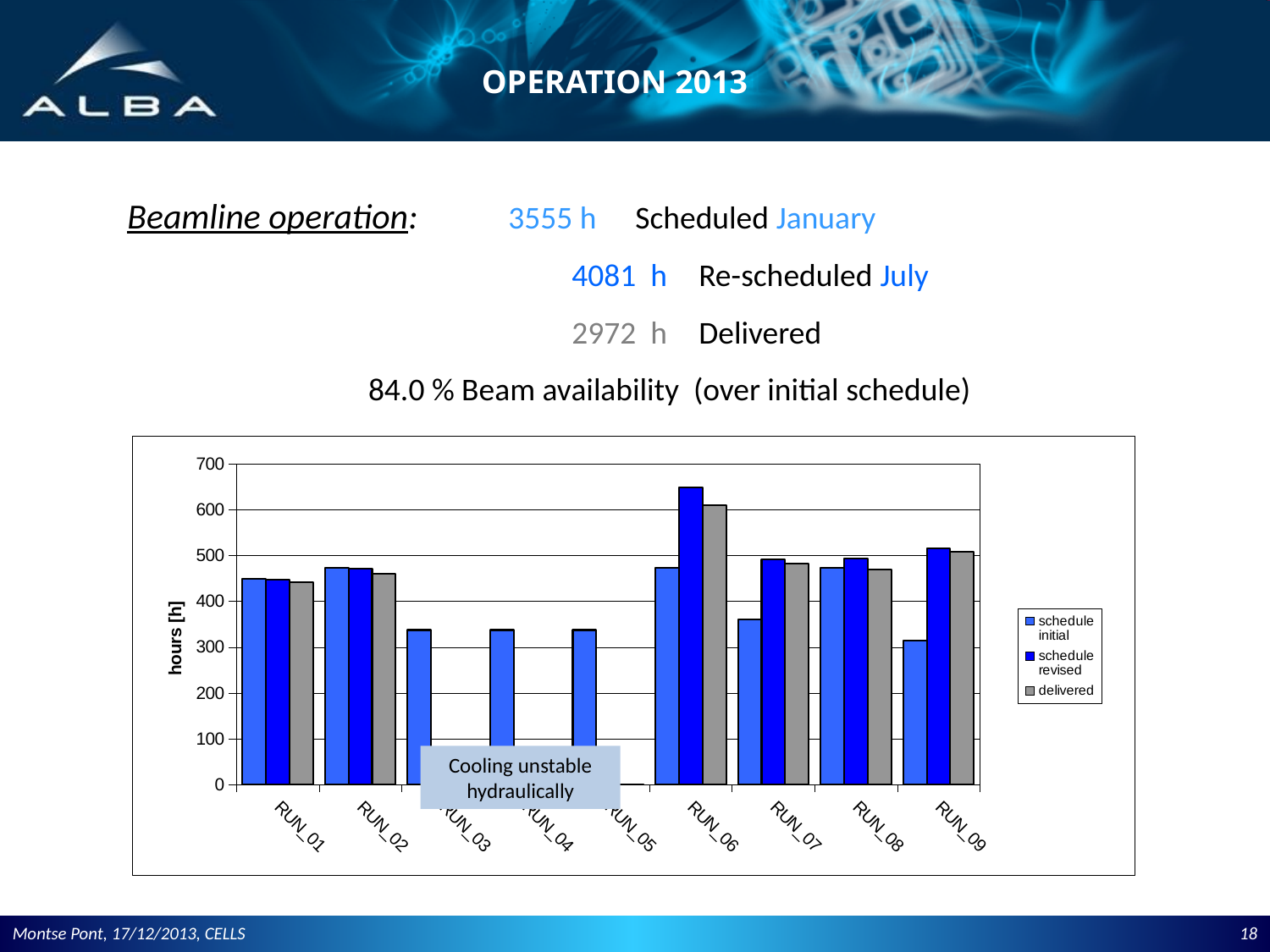
Is the 'schedule revised' value for RUN_06 greater or less than 600? greater Which run has the highest 'schedule revised' value? RUN_06 For RUN_09, which is larger: 'schedule initial' or 'schedule revised'? schedule revised How many series does the chart legend list? 3 Which run has the highest 'delivered' value? RUN_06 Which is larger: the 'schedule initial' value for RUN_07 or for RUN_08? RUN_08 Is the 'schedule initial' value for RUN_09 greater or less than 400? less Is the 'schedule initial' value for RUN_07 greater or less than 400? less What kind of chart is shown on the slide? bar chart How many runs (categories) are shown on the x axis of the chart? 9 What is the label of the chart's y axis? hours [h]